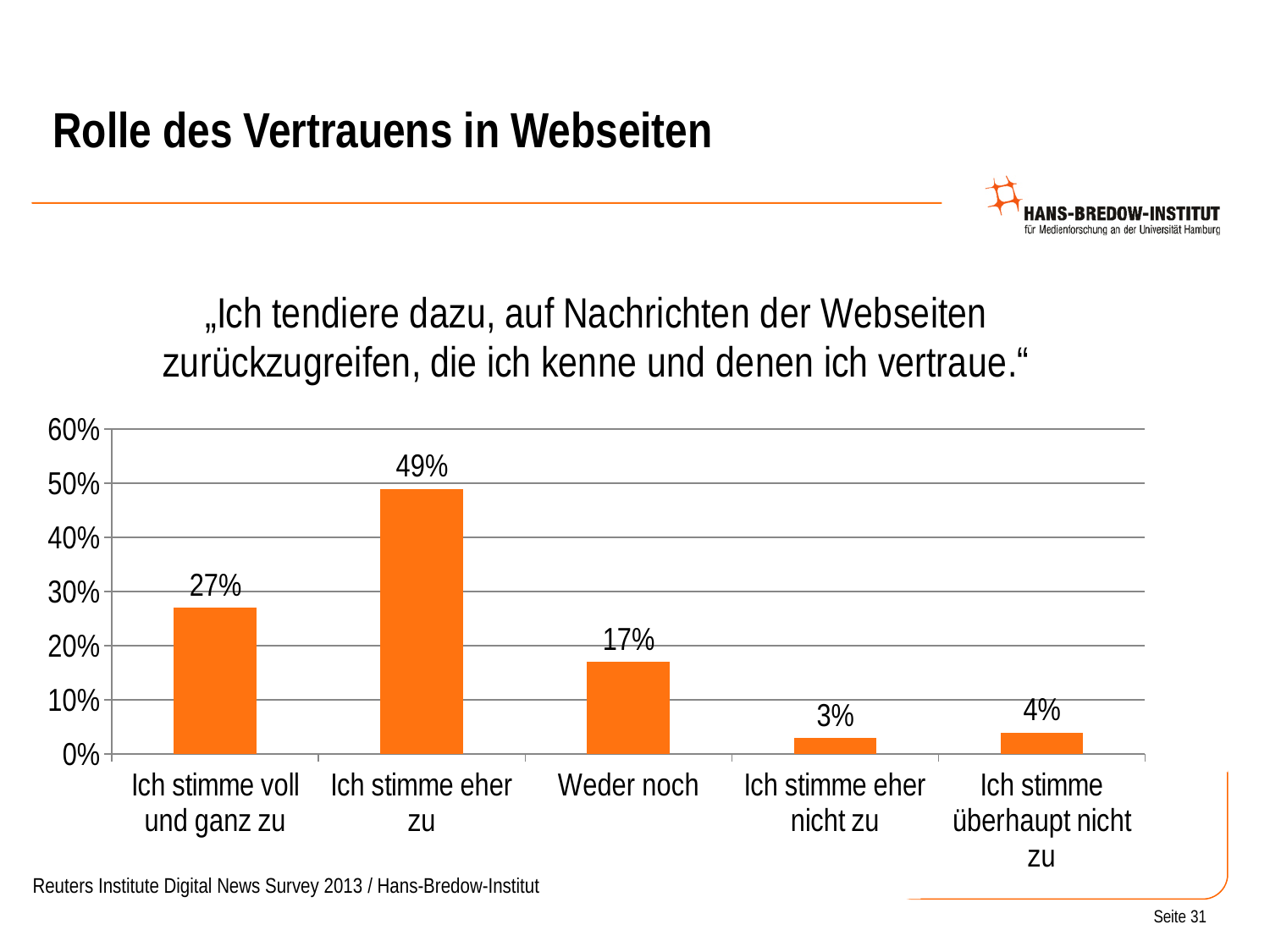
What kind of chart is shown on the slide? Bar chart Is the value for "Ich stimme eher zu" greater or less than 40%? greater How many categories are shown on the x axis? 5 Which is larger, the value for "Weder noch" or the value for "Ich stimme überhaupt nicht zu"? Weder noch Which category has the highest value? Ich stimme eher zu What is the value for "Weder noch"? 17% What is the value for "Ich stimme eher nicht zu"? 3% What is the value for "Ich stimme voll und ganz zu"? 27% What is the value for "Ich stimme eher zu"? 49% What is the highest value shown on the y axis? 60% Which category has the lowest value? Ich stimme eher nicht zu What is the difference between the values for "Ich stimme eher zu" and "Ich stimme voll und ganz zu"? 22%